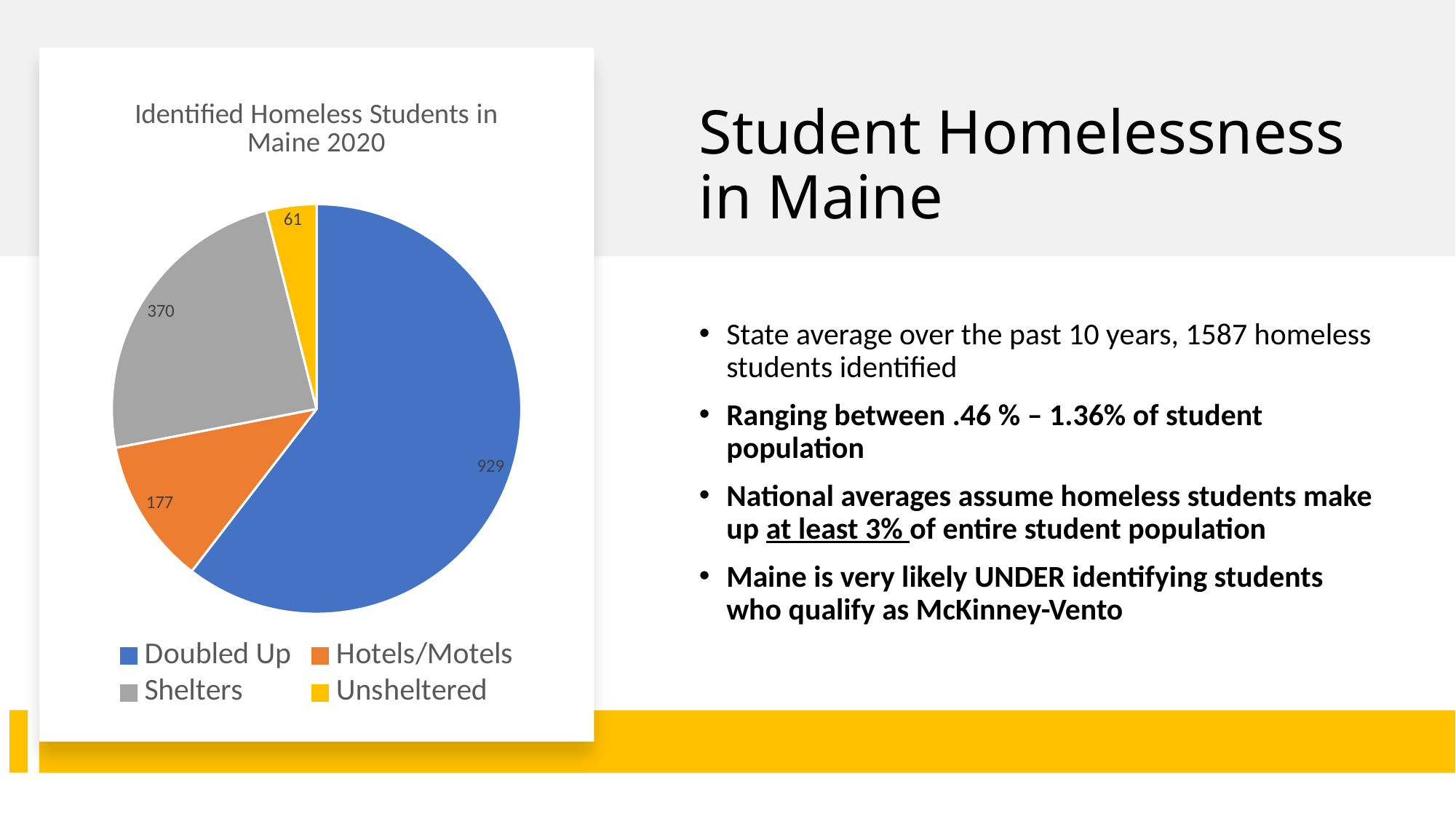
Which is larger, Shelters or Hotels/Motels? Shelters How many categories does the pie chart show? 4 What is the difference between the Shelters value and the Hotels/Motels value? 193 Which category has the largest slice? Doubled Up What is the value for Doubled Up? 929 What is the value for Unsheltered? 61 What is the value for Shelters? 370 What is the title of the chart? Identified Homeless Students in Maine 2020 What is the value for Hotels/Motels? 177 What colour is the Unsheltered slice? Yellow What type of chart is shown on the slide? Pie chart Which category has the smallest slice? Unsheltered